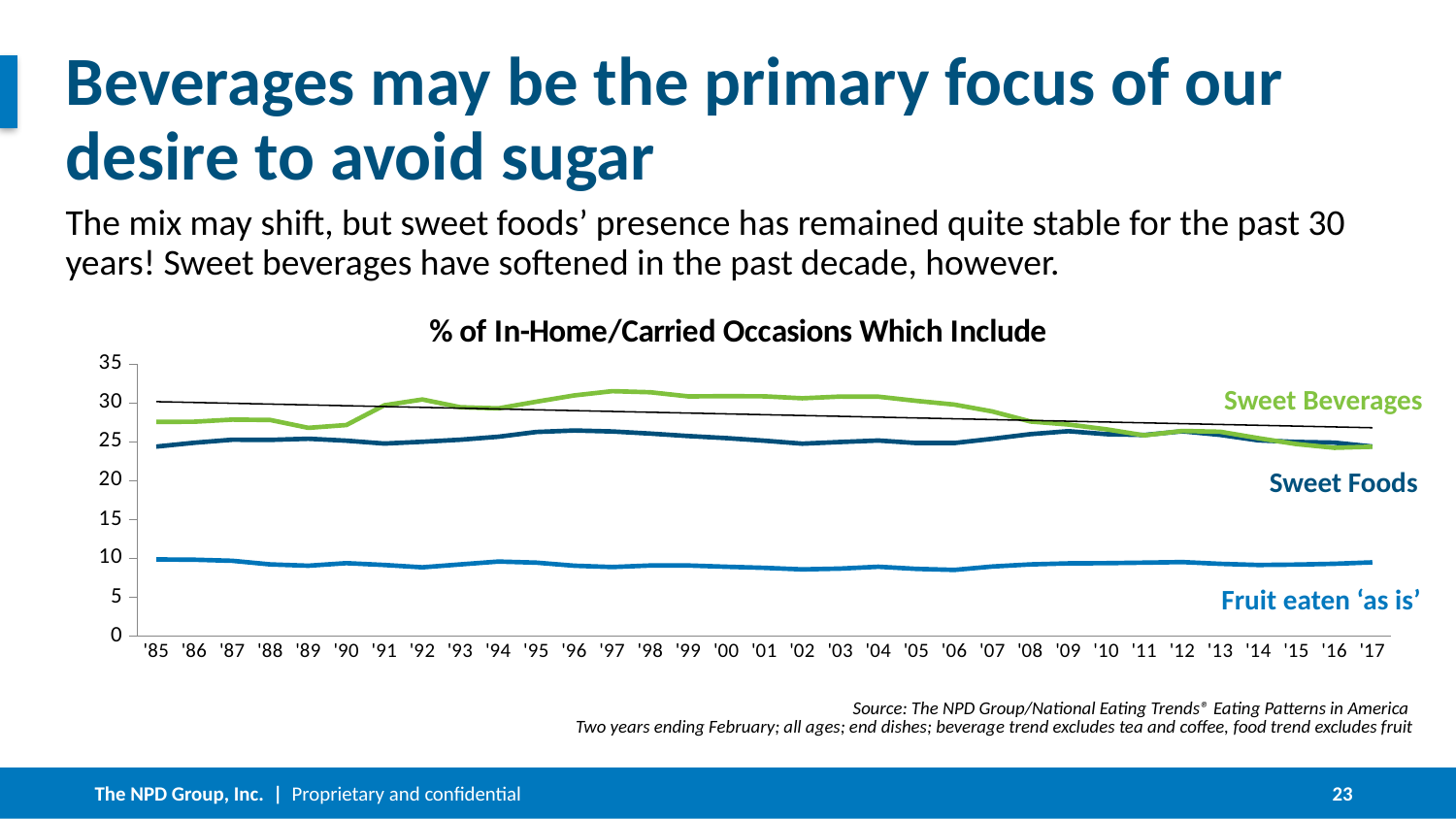
Is the value for Fruit eaten 'as is' in '06 greater or less than 10? less In '97, which is larger: Sweet Beverages or Sweet Foods? Sweet Beverages Which series has the lowest values across the whole chart? Fruit eaten 'as is' How many data series are labelled on the chart? 3 Is the value for Sweet Beverages in '97 greater or less than 30? greater Do the values for Sweet Beverages rise or fall from '08 to '17? fall Which series has the highest value in '00? Sweet Beverages Is the value for Sweet Beverages in '89 greater or less than 30? less What kind of chart is shown on the slide? line chart What colour is the Sweet Beverages line? green How many years are shown along the x axis of the chart? 33 What is the title of the chart? % of In-Home/Carried Occasions Which Include